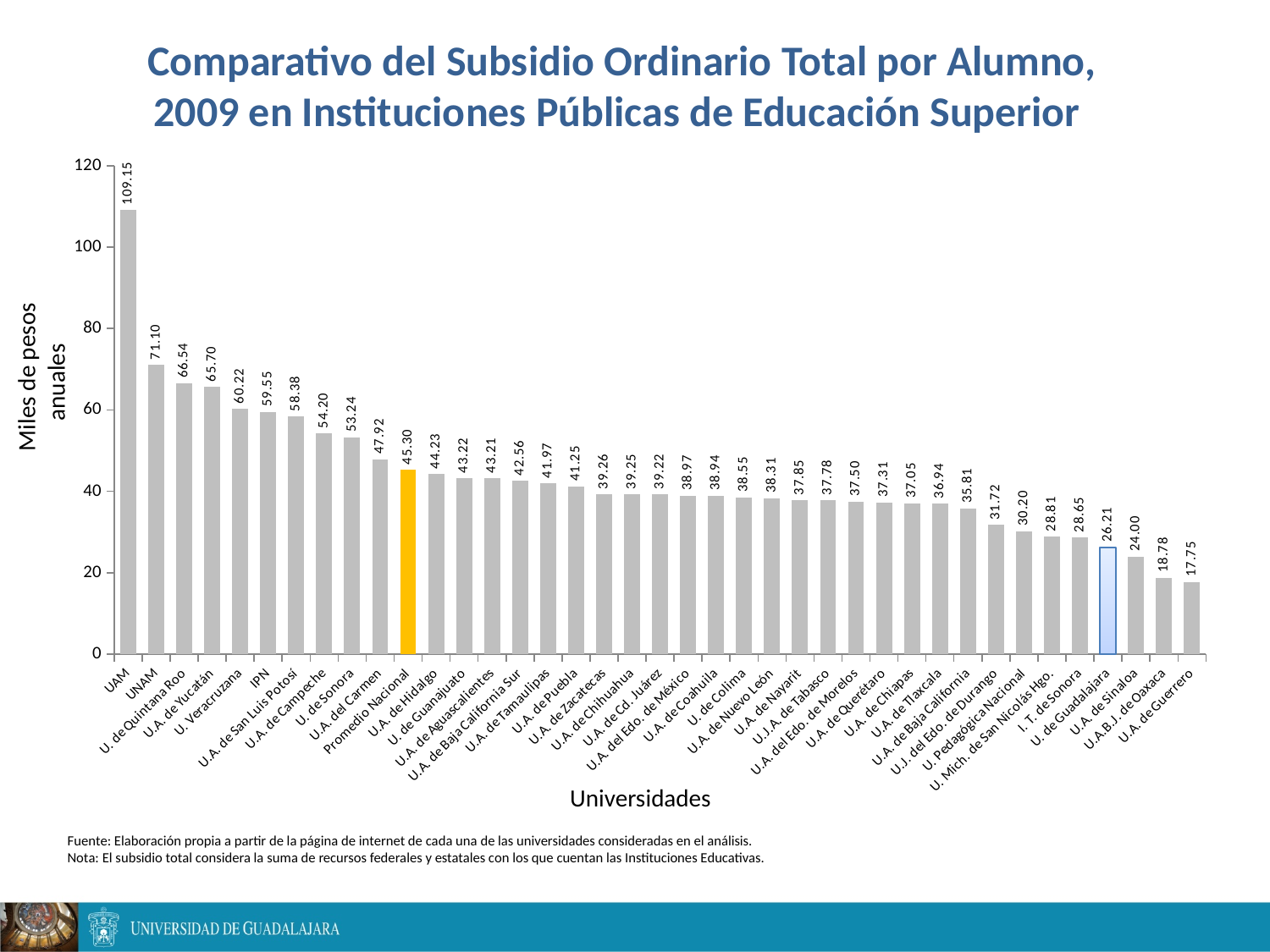
Which is larger, the value for UNAM or the value for IPN? UNAM Do the values rise or fall from left to right along the x axis? Fall Is the value for U.A. de Sinaloa greater or less than 20? greater Which university has the highest subsidy per student? UAM Which university has the lowest subsidy per student? U.A. de Guerrero What is the difference between the values for UAM and UNAM? 38.05 What kind of chart is shown on the slide? Bar chart How many bars are shown in the chart? 39 How much lower is U. de Guadalajara than Promedio Nacional? 19.09 What is the value for Promedio Nacional? 45.30 What is the value for U. de Guadalajara? 26.21 What is the value for UAM? 109.15